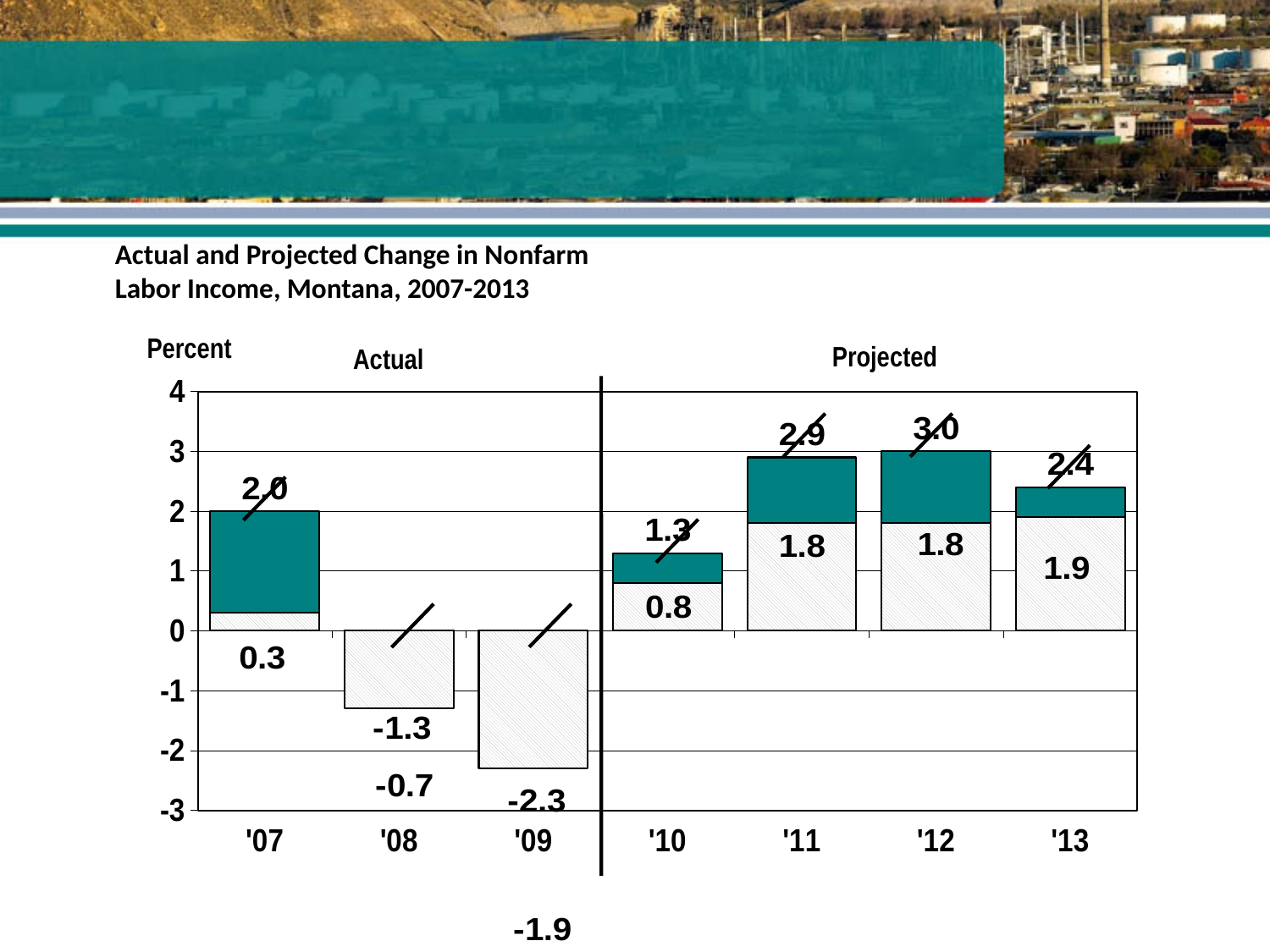
Which year has the highest bar top in the chart? '12 What value is printed at the top of the bar for '10? 1.3 How many years are shown along the x axis of the chart? 7 What value is printed below the hatched bar for '09? -2.3 What value is printed at the top of the bar for '13? 2.4 What value is printed at the top of the bar for '11? 2.9 What value is printed inside the hatched segment of the bar for '10? 0.8 Which section of the chart is labeled 'Projected', the left or the right? right What kind of chart is shown on the slide? bar chart What value is printed at the top of the bar for '12? 3.0 What value is printed inside the hatched segment of the bar for '13? 1.9 Which year has the lowest bar in the chart? '09